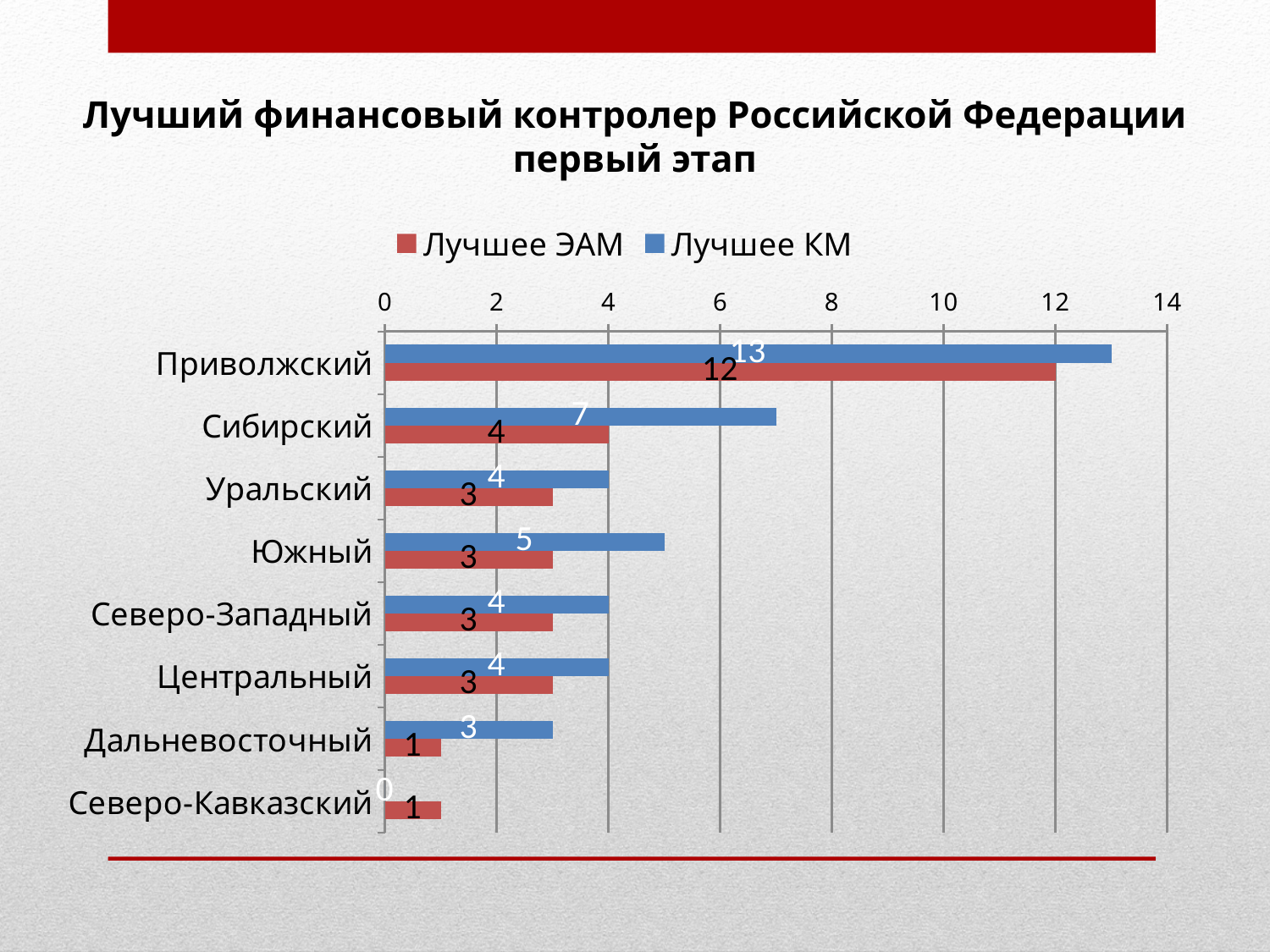
Which region has the highest value for Лучшее КМ? Приволжский Which region has the lowest value for Лучшее КМ? Северо-Кавказский What is the difference between Лучшее КМ and Лучшее ЭАМ for Сибирский? 3 What is the value of Лучшее КМ for Приволжский? 13 What is the value of Лучшее ЭАМ for Сибирский? 4 How many series does the legend list? 2 What type of chart is shown on the slide? bar chart How many categories (regions) are shown on the chart? 8 What is the value of Лучшее КМ for Южный? 5 Which is larger for Северо-Кавказский: Лучшее ЭАМ or Лучшее КМ? Лучшее ЭАМ Which colour represents the Лучшее КМ series? blue What is the value of Лучшее ЭАМ for Дальневосточный? 1